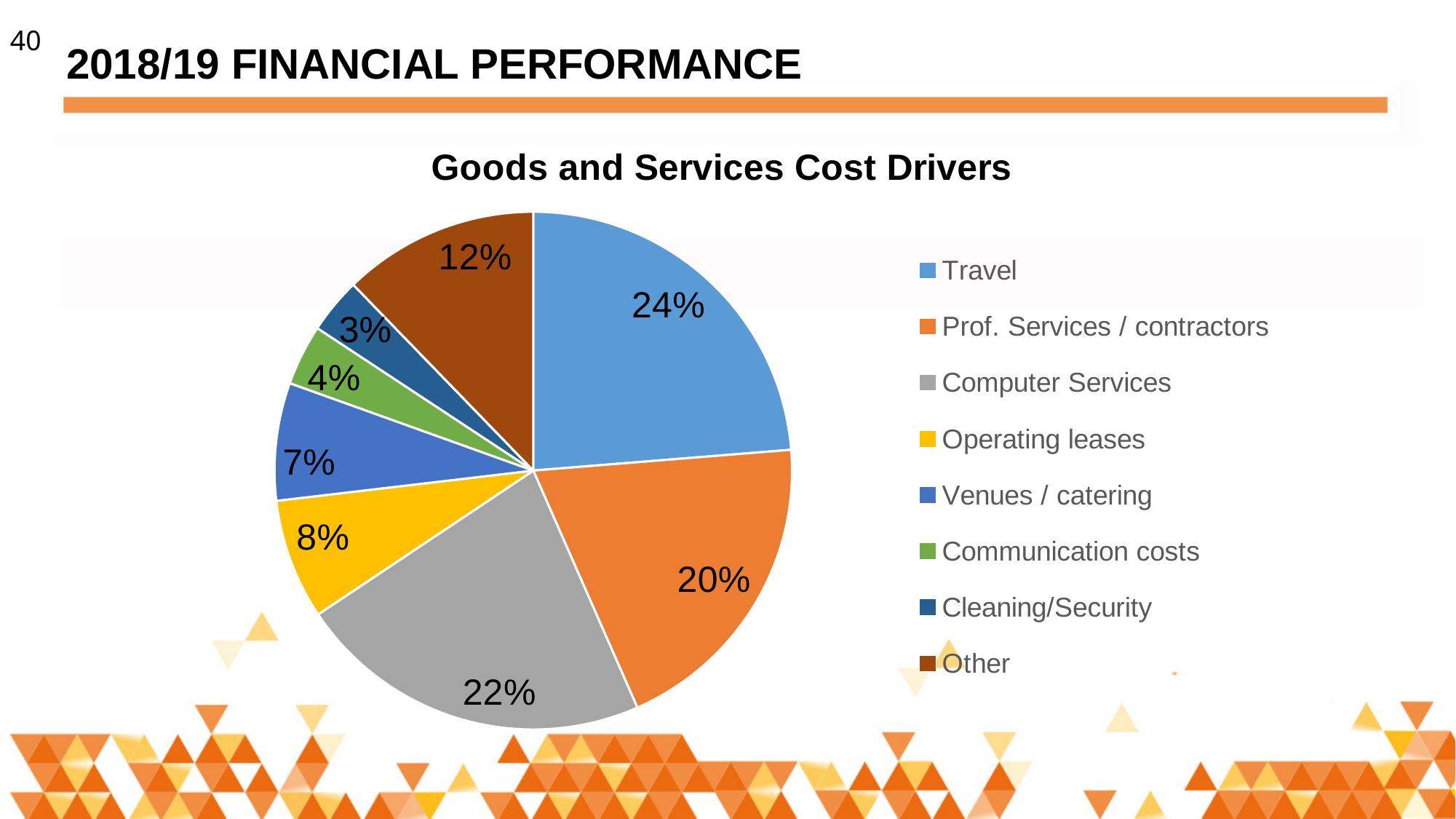
Which category has the largest share of the pie? Travel What share of the pie does Travel represent? 24% What is the value for Cleaning/Security? 3% What is the value for Operating leases? 8% Which is larger, the share for Communication costs or the share for Operating leases? Operating leases What is the value for Prof. Services / contractors? 20% What is the difference between the shares for Other and Venues / catering? 5% What type of chart is shown on the slide? pie chart What is the title of the chart? Goods and Services Cost Drivers Which category has the smallest share of the pie? Cleaning/Security How many categories does the legend list? 8 What share of the pie does Computer Services represent? 22%